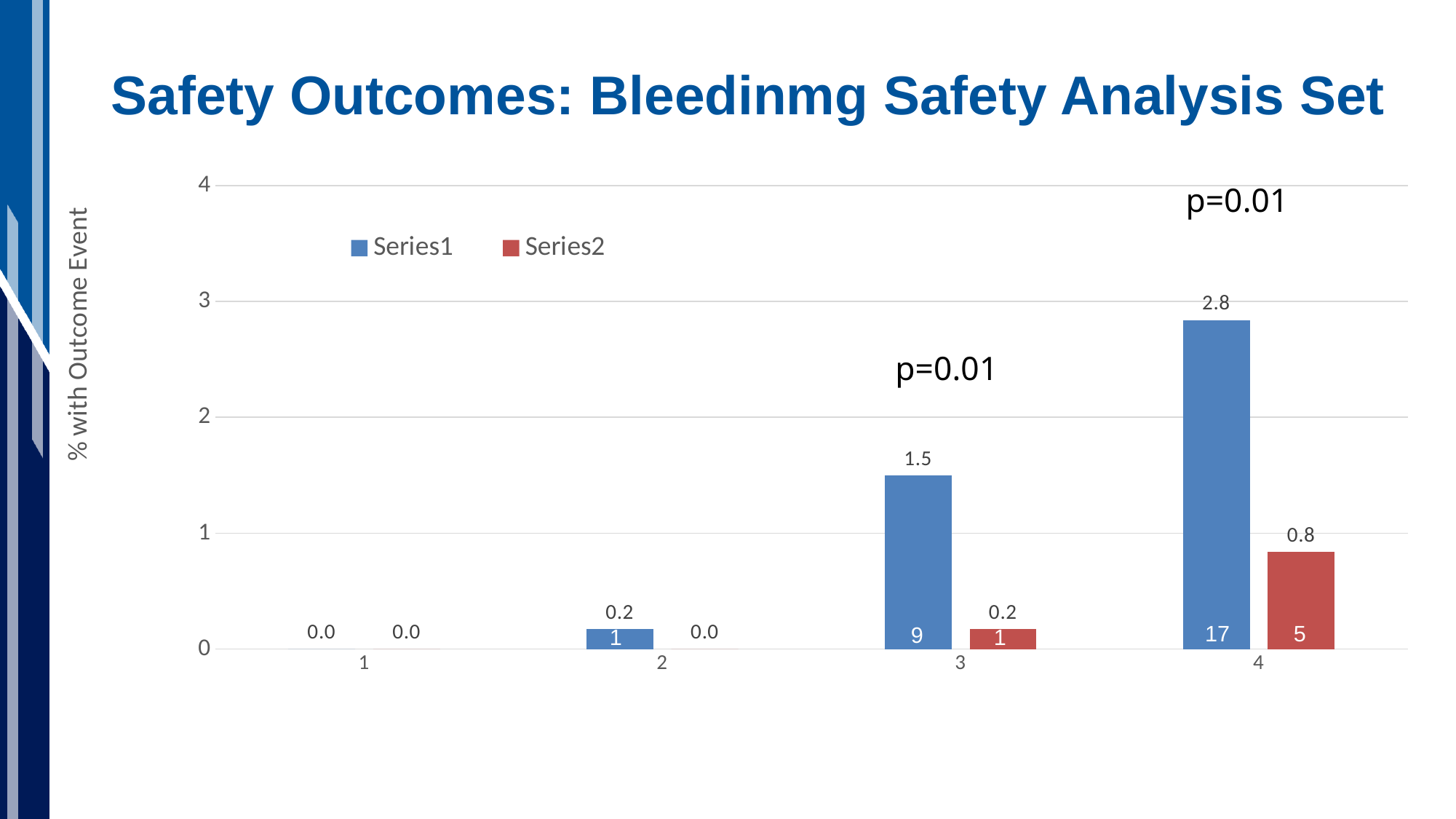
What is the value for Series2 at category 3? 0.2 Which category has the highest value for Series1? 4 How many series does the legend list? 2 What is the value for Series1 at category 2? 0.2 What kind of chart is shown on the slide? Bar chart What is the difference between Series1 and Series2 at category 4? 2.0 Which category has the highest value for Series2? 4 Which is larger at category 3, Series1 or Series2? Series1 How many categories are shown on the x axis? 4 What is the value for Series1 at category 4? 2.8 What is the value for Series2 at category 4? 0.8 What is the difference between Series1 and Series2 at category 3? 1.3